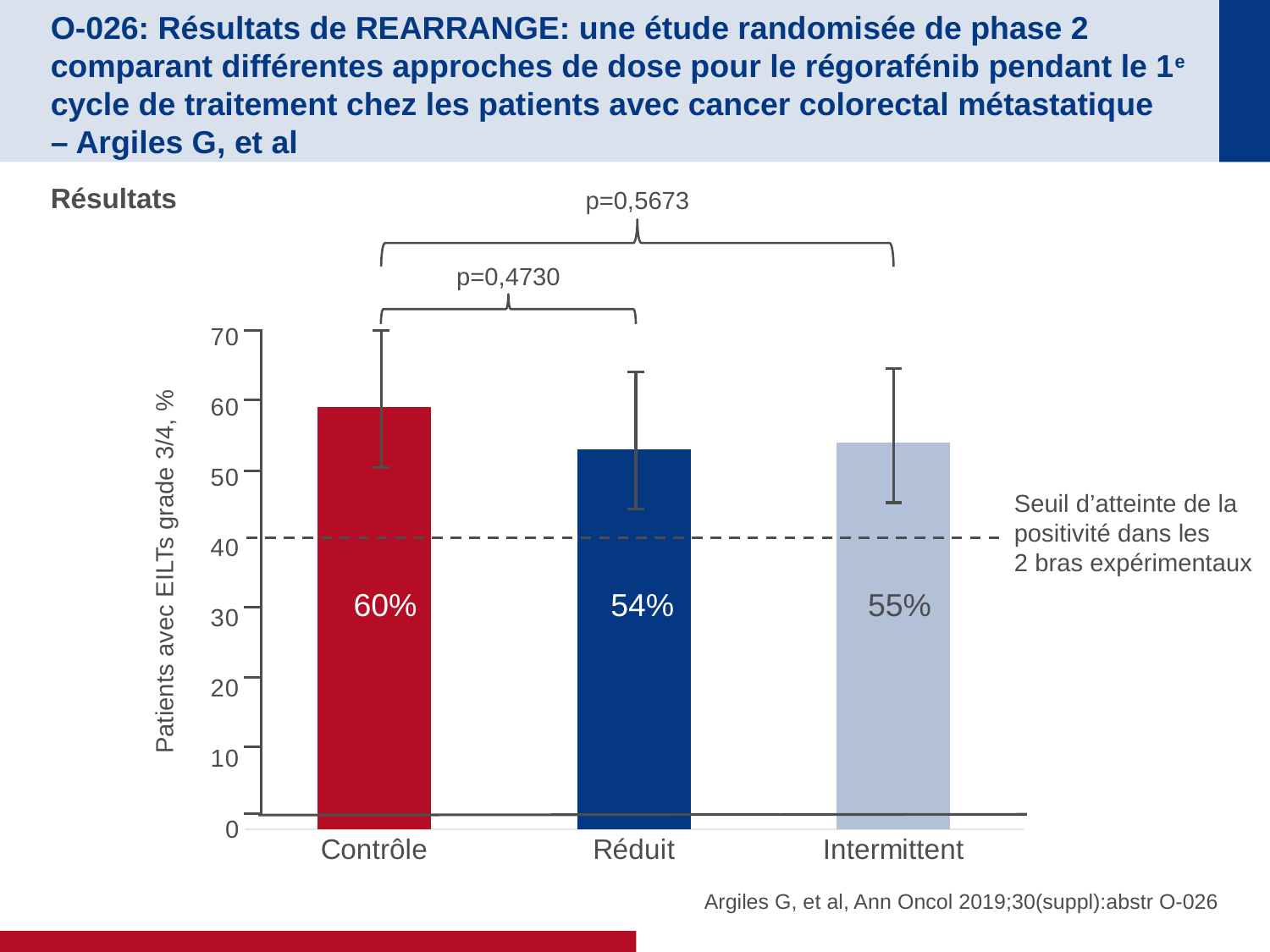
What p-value is shown for the comparison between Contrôle and Réduit? p=0,4730 What is the value for Intermittent? 55% What is the value for Réduit? 54% What kind of chart is shown on the slide? bar chart What p-value is shown for the comparison between Contrôle and Intermittent? p=0,5673 Which is larger, the value for Contrôle or the value for Intermittent? Contrôle Is the value for Intermittent greater or less than 50? greater What is the difference between the values for Contrôle and Réduit? 6 percentage points Which arm has the highest percentage of patients with grade 3/4 EILTs? Contrôle What is the value for Contrôle? 60% How many arms (categories) are shown on the x axis? 3 Which arm has the lowest percentage of patients with grade 3/4 EILTs? Réduit